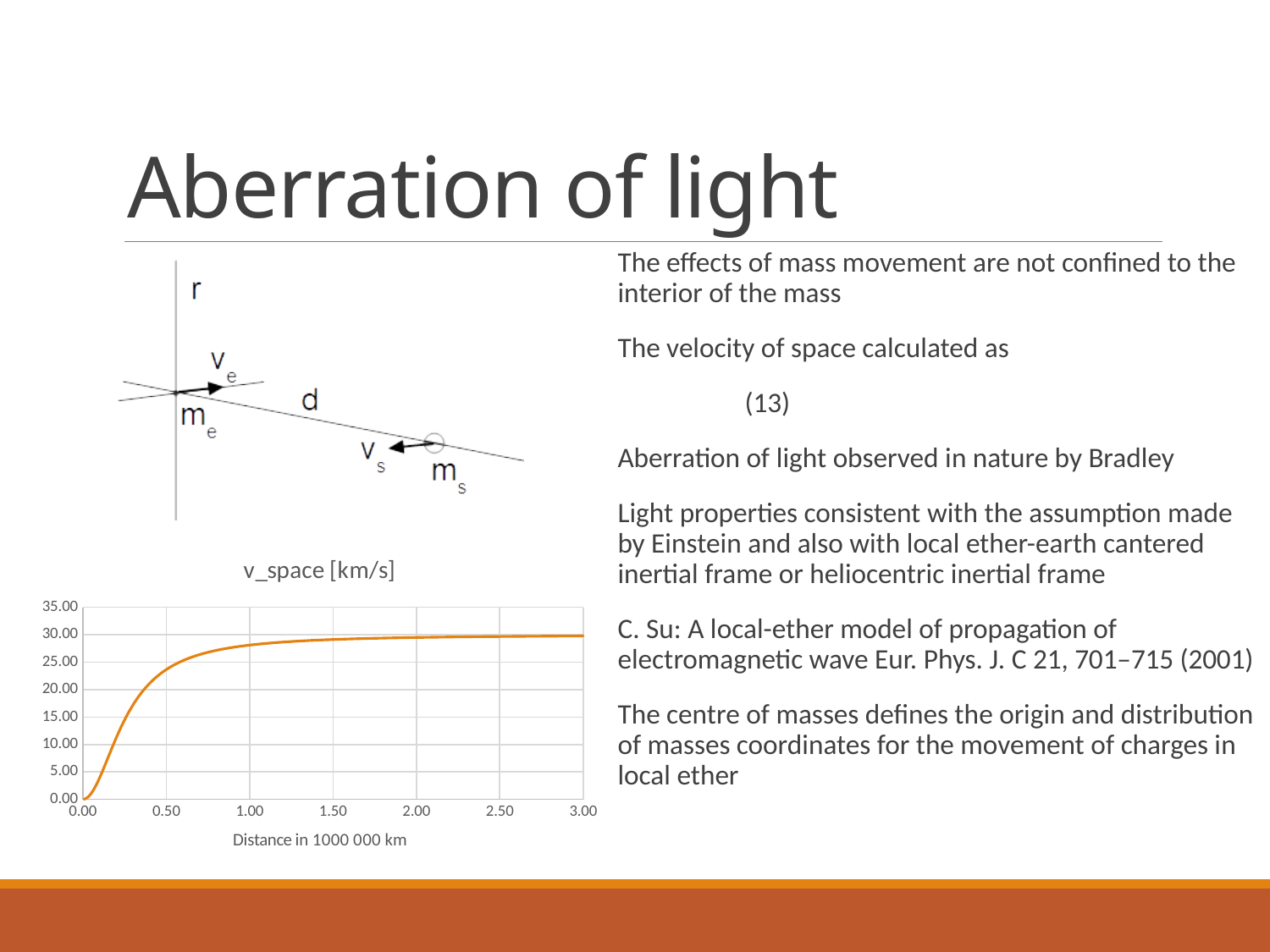
Which is larger, the value of v_space at a distance of 0.50 or at a distance of 2.50? 2.50 Is the value of v_space at a distance of 2.00 greater or less than 25.00? greater Is the value of v_space at a distance of 0.10 greater or less than 10.00? less Is the value of v_space at a distance of 3.00 greater or less than 35.00? less What kind of chart is shown on the slide? line chart Does the value of v_space rise or fall as distance increases along the x axis? rise What is the title of the chart? v_space [km/s] What is the highest value shown on the y axis of the chart? 35.00 What is the label of the x axis of the chart? Distance in 1000 000 km